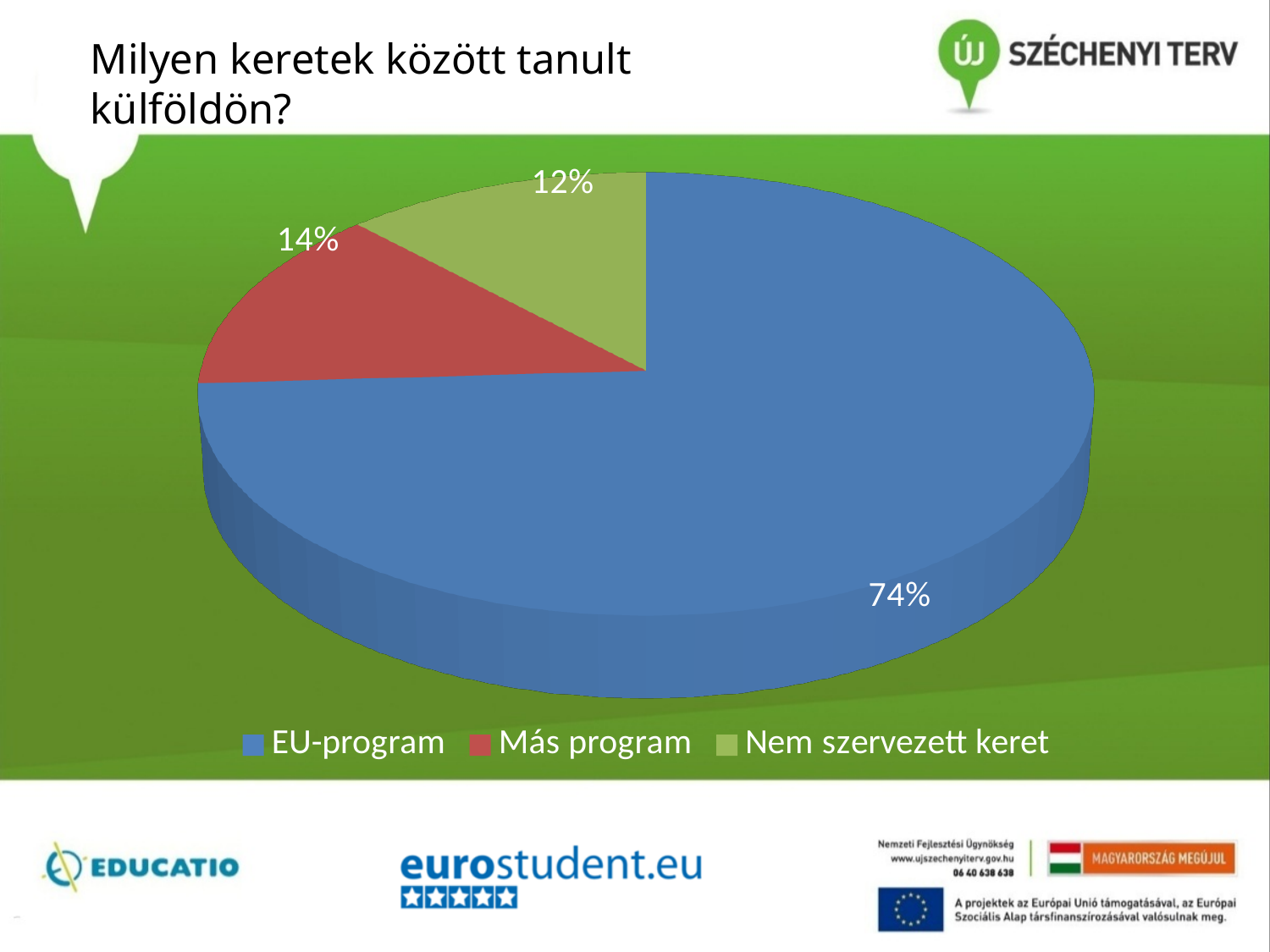
What kind of chart is shown on the slide? pie chart Which is larger, the slice for Más program or the slice for Nem szervezett keret? Más program What share of the pie does EU-program have? 74% How many categories does the pie chart show? 3 Which category has the largest slice of the pie? EU-program What is the difference in percentage points between EU-program and Más program? 60 What share of the pie does Nem szervezett keret have? 12% What share of the pie does Más program have? 14% Which category has the smallest slice of the pie? Nem szervezett keret What is the title of the slide above the chart? Milyen keretek között tanult külföldön? Which colour represents Más program in the legend? red What is the difference in percentage points between Más program and Nem szervezett keret? 2